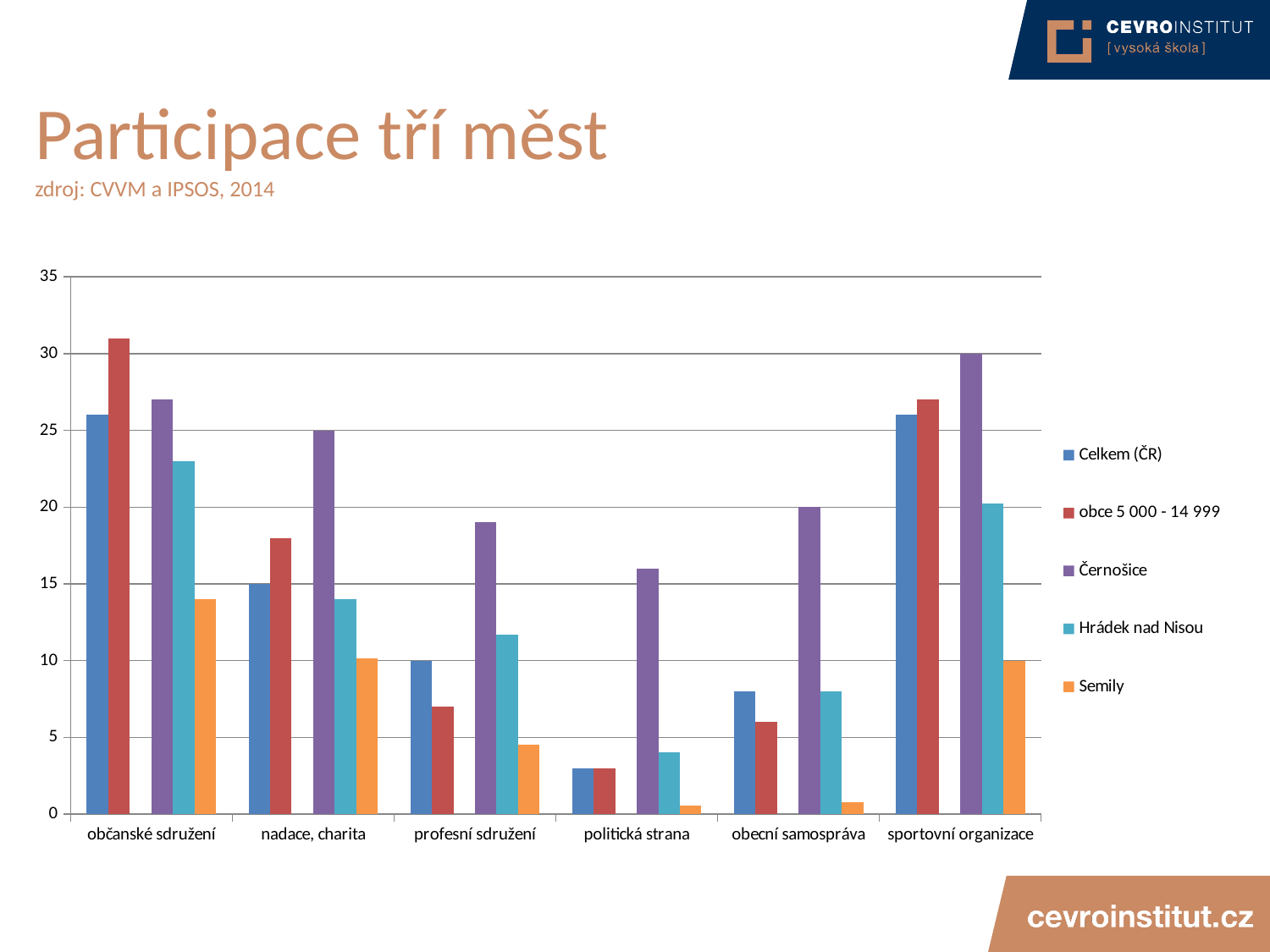
Which category has the highest value for Černošice? sportovní organizace What is the title of the slide containing the chart? Participace tří měst Is the value for Hrádek nad Nisou in profesní sdružení greater or less than 10? greater Which category has the lowest value for Semily? politická strana How many categories are shown on the x axis? 6 What kind of chart is shown on the slide? bar chart In politická strana, which is larger: Černošice or Hrádek nad Nisou? Černošice Is the value for obce 5 000 - 14 999 in občanské sdružení greater or less than 30? greater Which series has the highest value in obecní samospráva? Černošice Is the value for Celkem (ČR) in občanské sdružení greater or less than 25? greater How many series does the legend list? 5